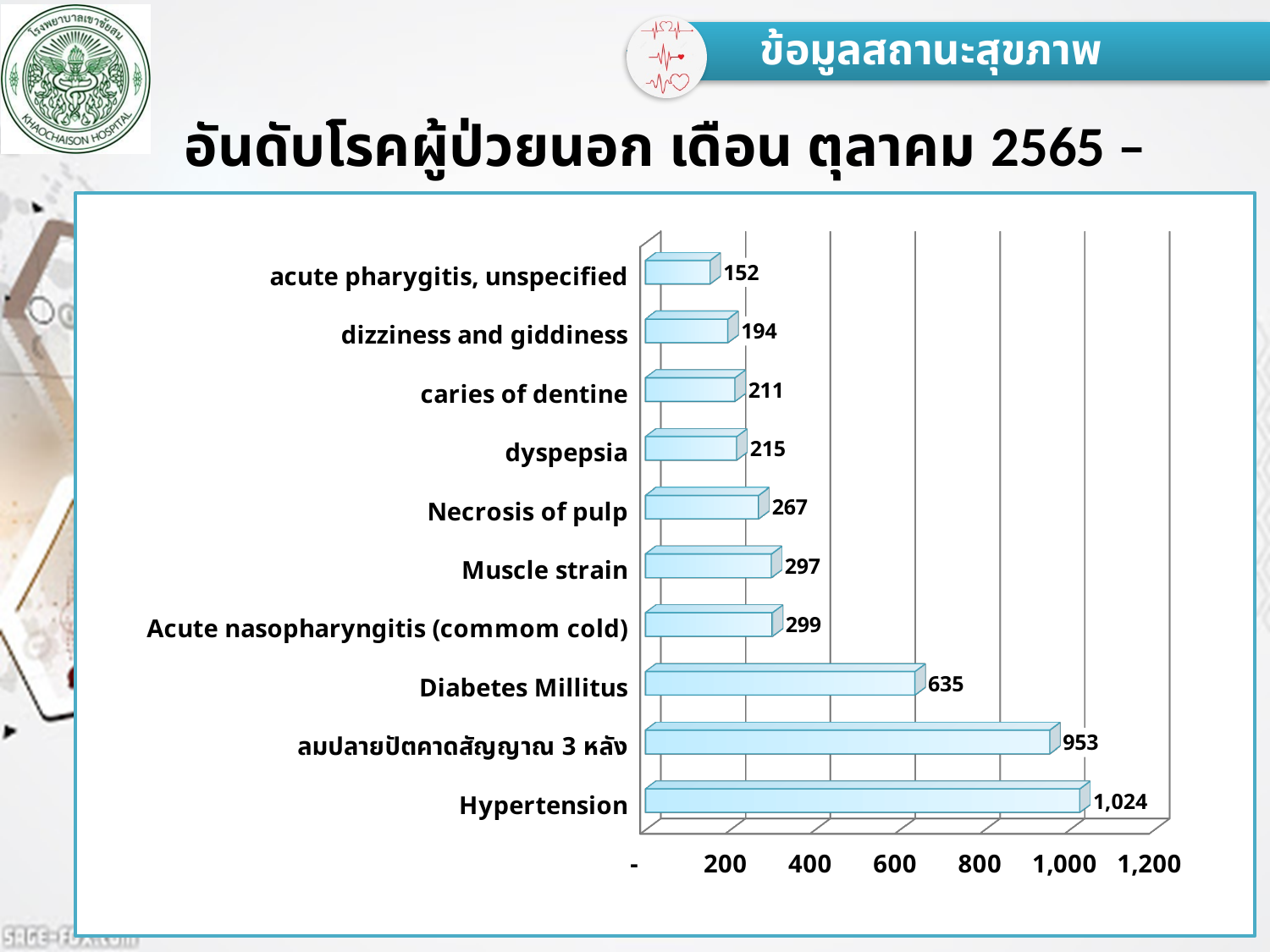
What is the value for Hypertension? 1,024 Which category has the lowest value? acute pharygitis, unspecified What is the value for Acute nasopharyngitis (commom cold)? 299 What is the difference between the values for Necrosis of pulp and caries of dentine? 56 What is the difference between the values for Hypertension and Diabetes Millitus? 389 How many categories are shown in the chart? 10 Which is larger, the value for Muscle strain or the value for dizziness and giddiness? Muscle strain What kind of chart is shown on the slide? bar chart What is the value for Diabetes Millitus? 635 Which category has the highest value? Hypertension What is the value for dyspepsia? 215 Is the value for Diabetes Millitus greater or less than 600? greater